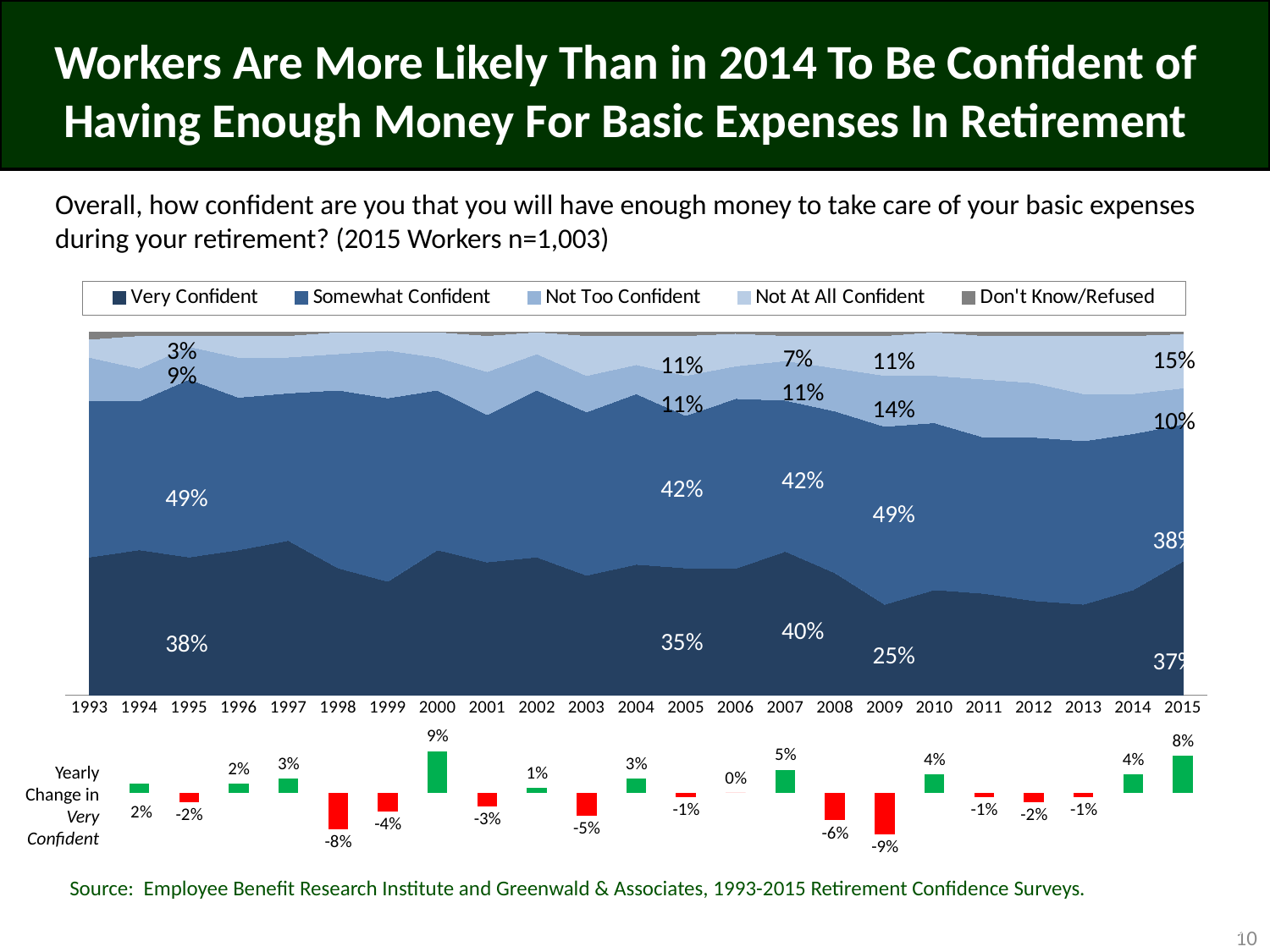
How many years are shown on the x axis of the 'Yearly Change in Very Confident' bar chart? 23 In the main stacked area chart, what percentage of workers were Very Confident in 2007? 40% In the main stacked area chart, which is larger: the Very Confident share in 2007 or in 2009? 2007 In the 'Yearly Change in Very Confident' bar chart, which year has the lowest value? 2009 How many series does the legend of the main chart list? 5 In the main stacked area chart, what percentage of workers were Not At All Confident in 2015? 15% In the 'Yearly Change in Very Confident' bar chart, which year has the highest value? 2000 What kind of chart is the 'Yearly Change in Very Confident' chart at the bottom of the slide? Bar chart In the main stacked area chart, what is the difference between the Very Confident share in 2015 and in 2009? 12 percentage points In the main stacked area chart, what percentage of workers were Somewhat Confident in 2009? 49% In the main stacked area chart, what percentage of workers were Very Confident in 2015? 37% In the 'Yearly Change in Very Confident' bar chart, what is the value for 2015? 8%